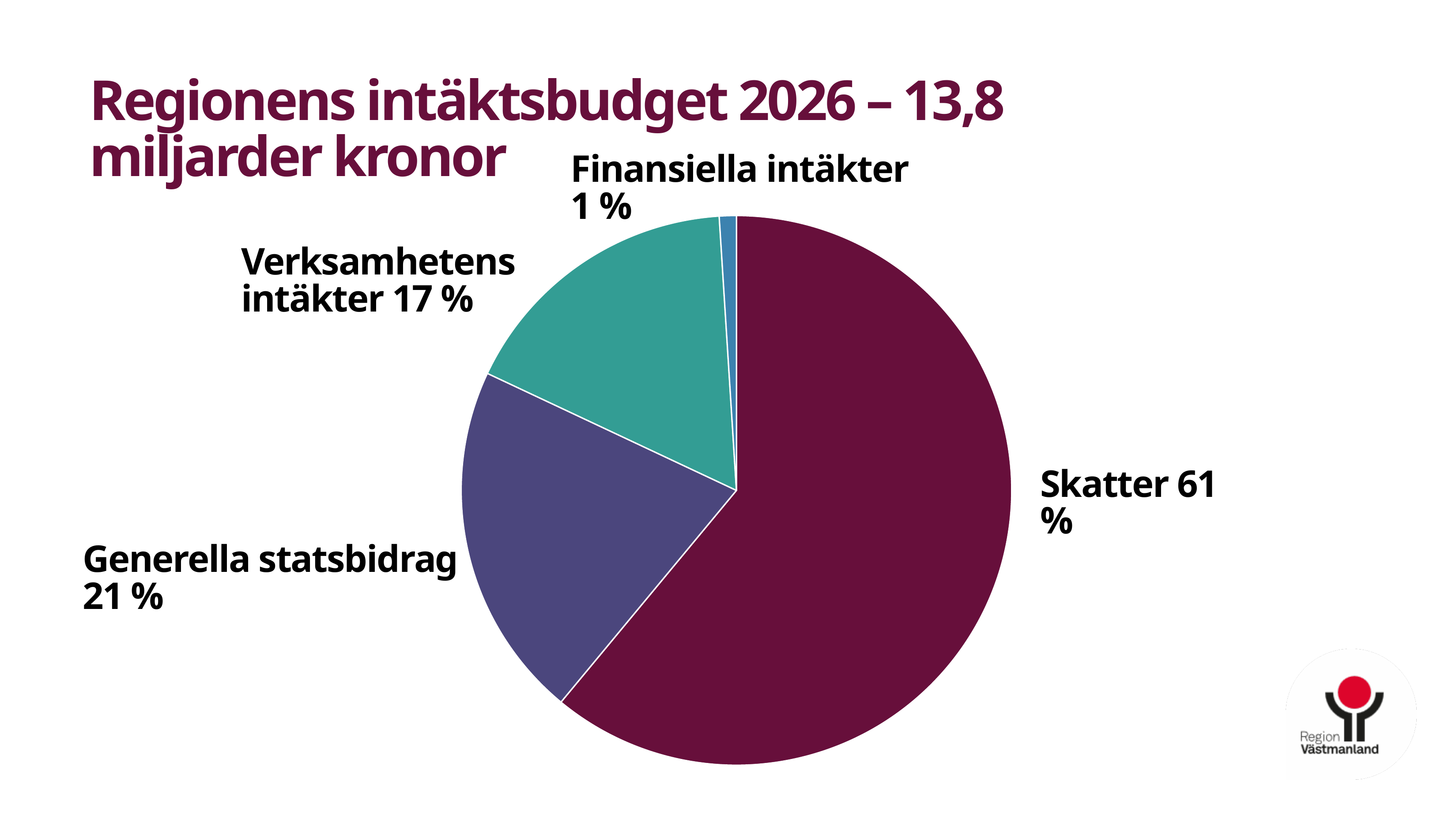
What share of the pie does Skatter represent? 61 % What kind of chart is shown on the slide? Pie chart What share of the pie does Verksamhetens intäkter represent? 17 % What share of the pie does Generella statsbidrag represent? 21 % Which category has the smallest slice of the pie? Finansiella intäkter What is the difference in percentage points between Skatter and Generella statsbidrag? 40 Which category has the largest slice of the pie? Skatter Which is larger, Generella statsbidrag or Verksamhetens intäkter? Generella statsbidrag What is the title of the slide containing the pie chart? Regionens intäktsbudget 2026 – 13,8 miljarder kronor What colour is the Skatter slice? Dark red (burgundy) How many slices does the pie chart have? 4